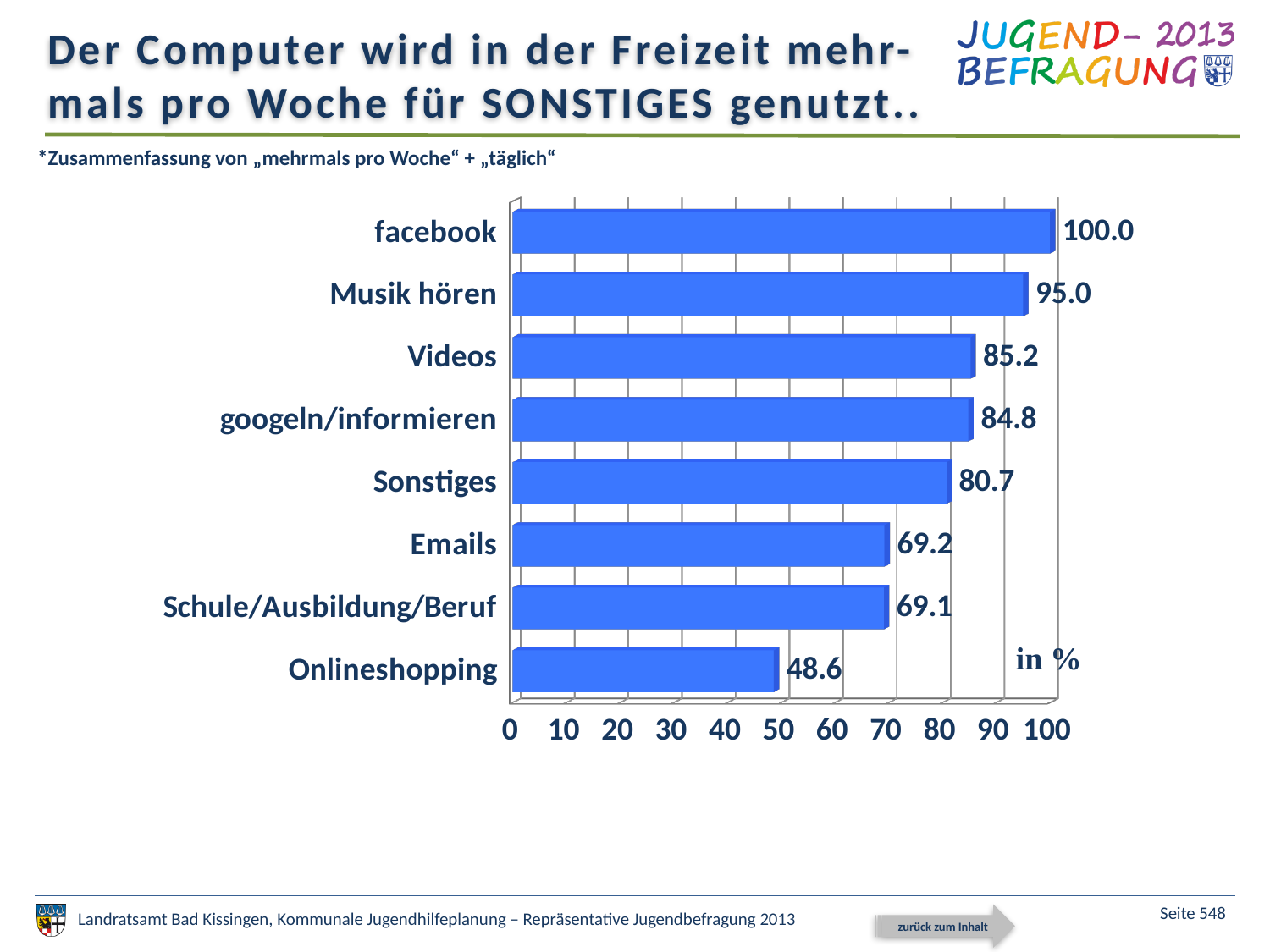
What kind of chart is shown on the slide? bar chart Which category has the lowest value? Onlineshopping What unit is indicated for the values in the chart? in % How many categories are shown in the chart? 8 What is the value for googeln/informieren? 84.8 What is the value for Onlineshopping? 48.6 What is the value for Sonstiges? 80.7 Which category has the highest value? facebook What is the difference between the values for Sonstiges and Onlineshopping? 32.1 Which is larger, the value for Videos or the value for Emails? Videos Is the value for Schule/Ausbildung/Beruf greater or less than 60? greater What is the difference between the values for facebook and Musik hören? 5.0